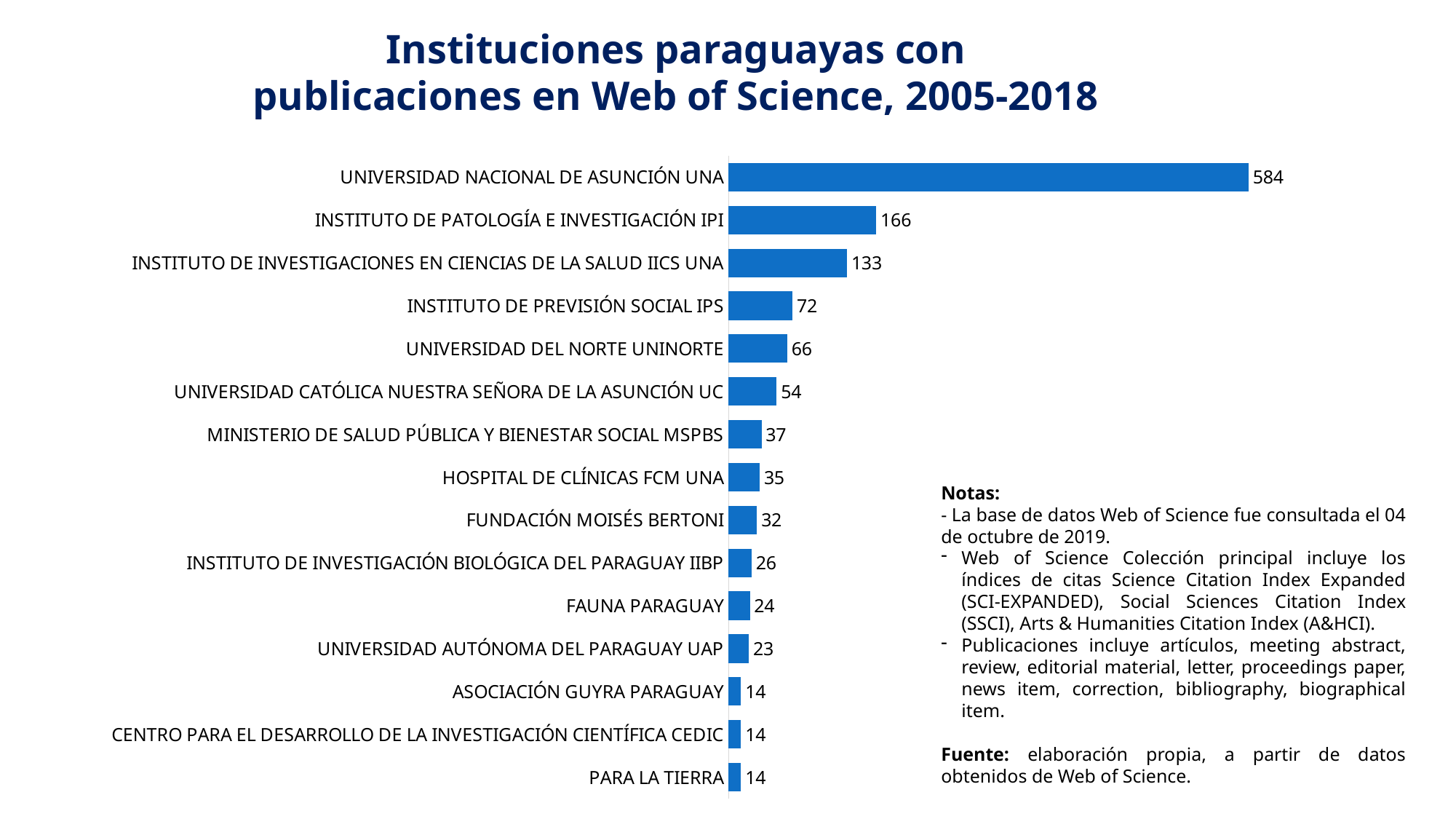
How many institutions are listed in the chart? 15 What is the difference between the values for Instituto de Patología e Investigación IPI and Instituto de Investigaciones en Ciencias de la Salud IICS UNA? 33 Which has a larger value, Universidad del Norte UNINORTE or Universidad Católica Nuestra Señora de la Asunción UC? Universidad del Norte UNINORTE How many institutions have a value of 14? 3 What is the value shown for Instituto de Previsión Social IPS? 72 Which institution has the highest number of publications? Universidad Nacional de Asunción UNA How many publications does Universidad Nacional de Asunción UNA have in the chart? 584 What is the difference between the values for Universidad Nacional de Asunción UNA and Instituto de Patología e Investigación IPI? 418 What kind of chart is shown on the slide? Bar chart What is the title of the chart? Instituciones paraguayas con publicaciones en Web of Science, 2005-2018 What is the value shown for Fundación Moisés Bertoni? 32 What is the value shown for Universidad Autónoma del Paraguay UAP? 23